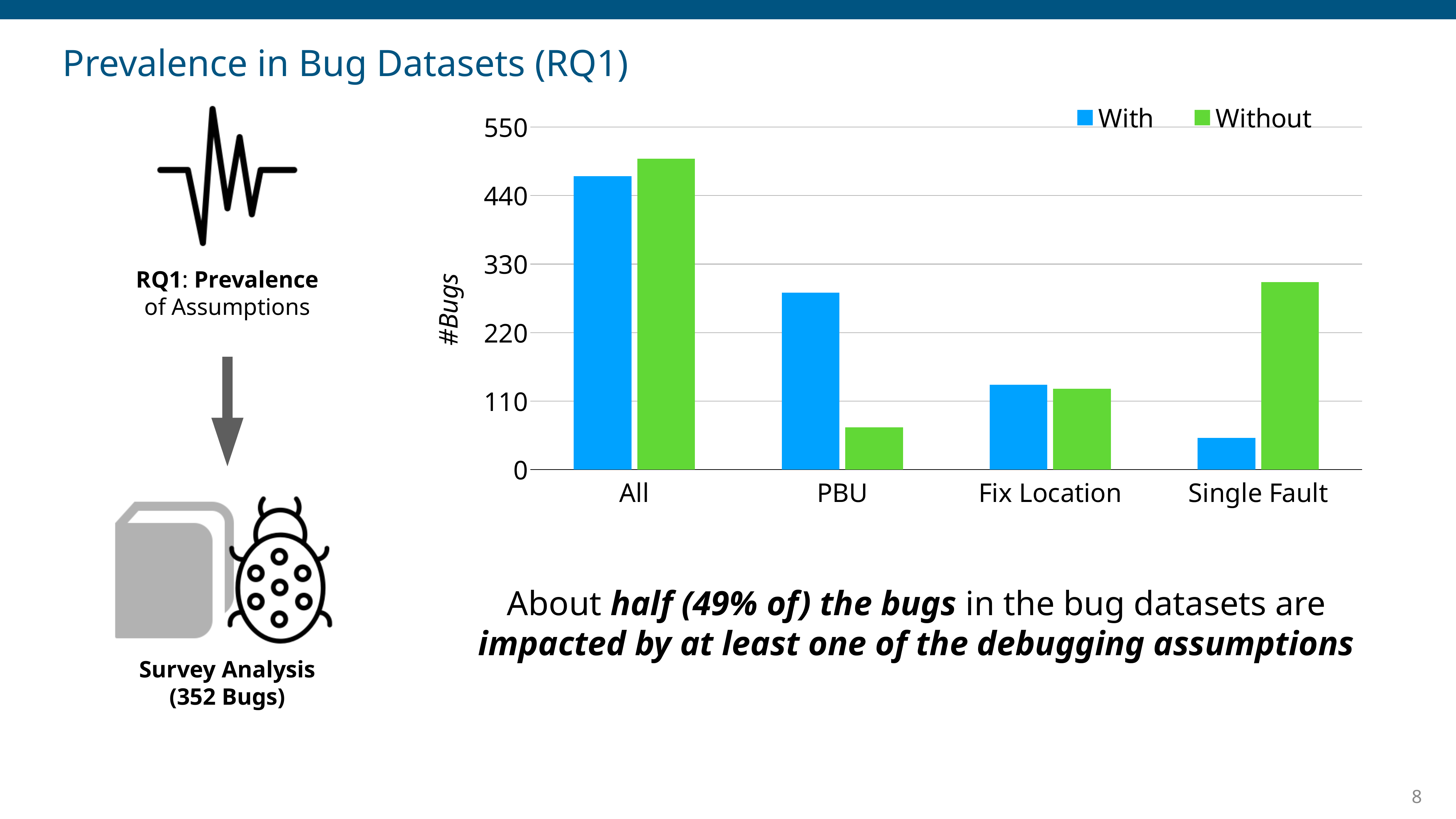
Which category has the shortest 'Without' bar? PBU Is the 'With' value for All greater or less than 440? greater Is the 'Without' value for PBU greater or less than 110? less How many categories are shown on the x axis of the chart? 4 Which category has the tallest 'With' bar? All For PBU, which is larger: the 'With' bar or the 'Without' bar? With What kind of chart is shown on the slide? bar chart How many series does the chart legend list? 2 What is the label of the y axis of the chart? #Bugs Is the 'Without' value for Single Fault greater or less than 330? less Which category has the shortest 'With' bar? Single Fault For Single Fault, which is larger: the 'With' bar or the 'Without' bar? Without